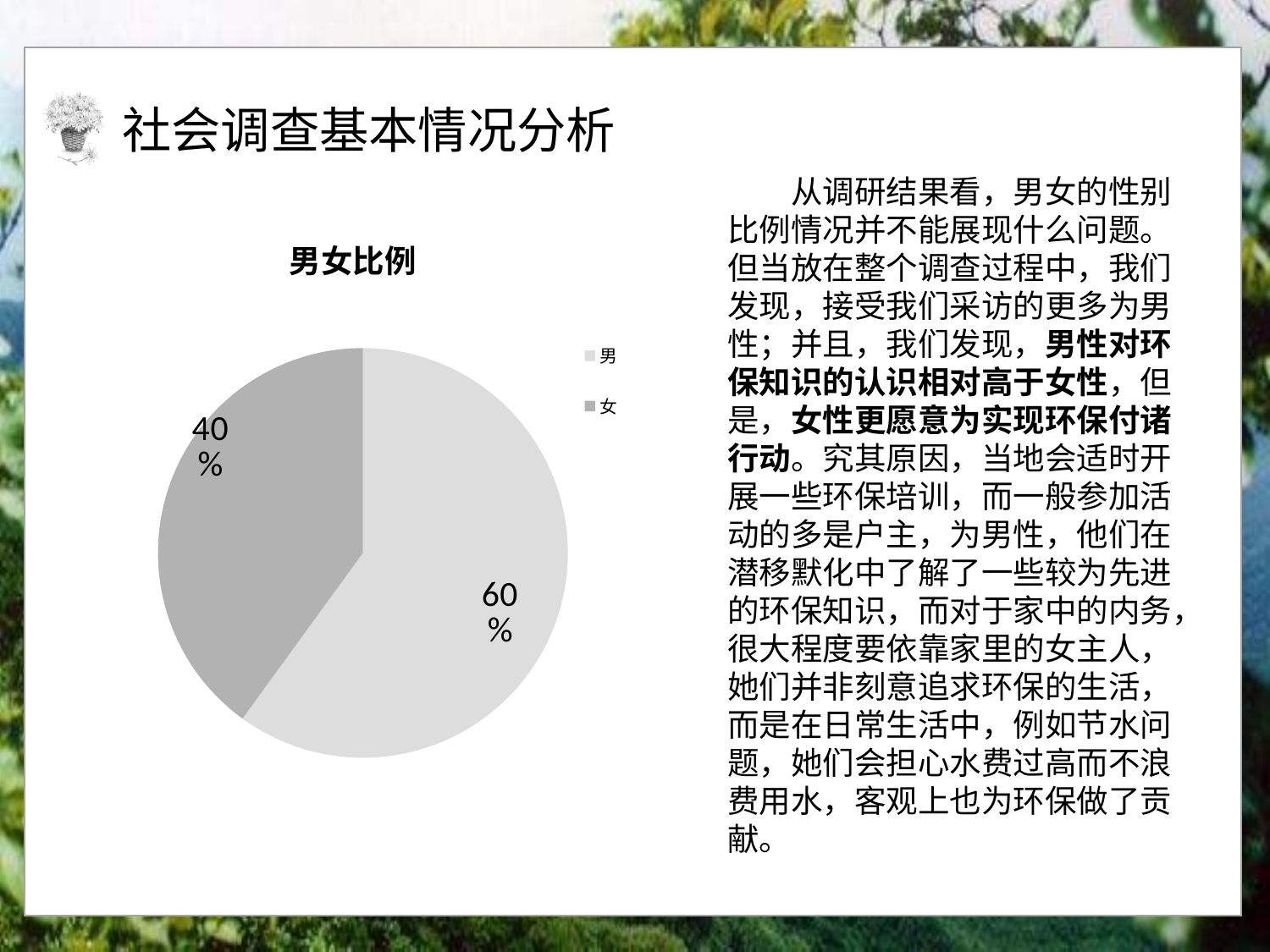
Is the share for 女 greater or less than 50%? less What share of the pie does 女 (female) take? 40% What kind of chart is shown on the slide? pie chart What share of the pie does 男 (male) take? 60% What is the title of the chart? 男女比例 Which category has the smallest slice of the pie? 女 Which legend entry is shown in the darker grey colour? 女 Which slice is larger, 男 or 女? 男 How many slices does the pie chart have? 2 Which category has the largest slice of the pie? 男 What is the difference in percentage points between the 男 and 女 slices? 20% How many entries does the legend list? 2